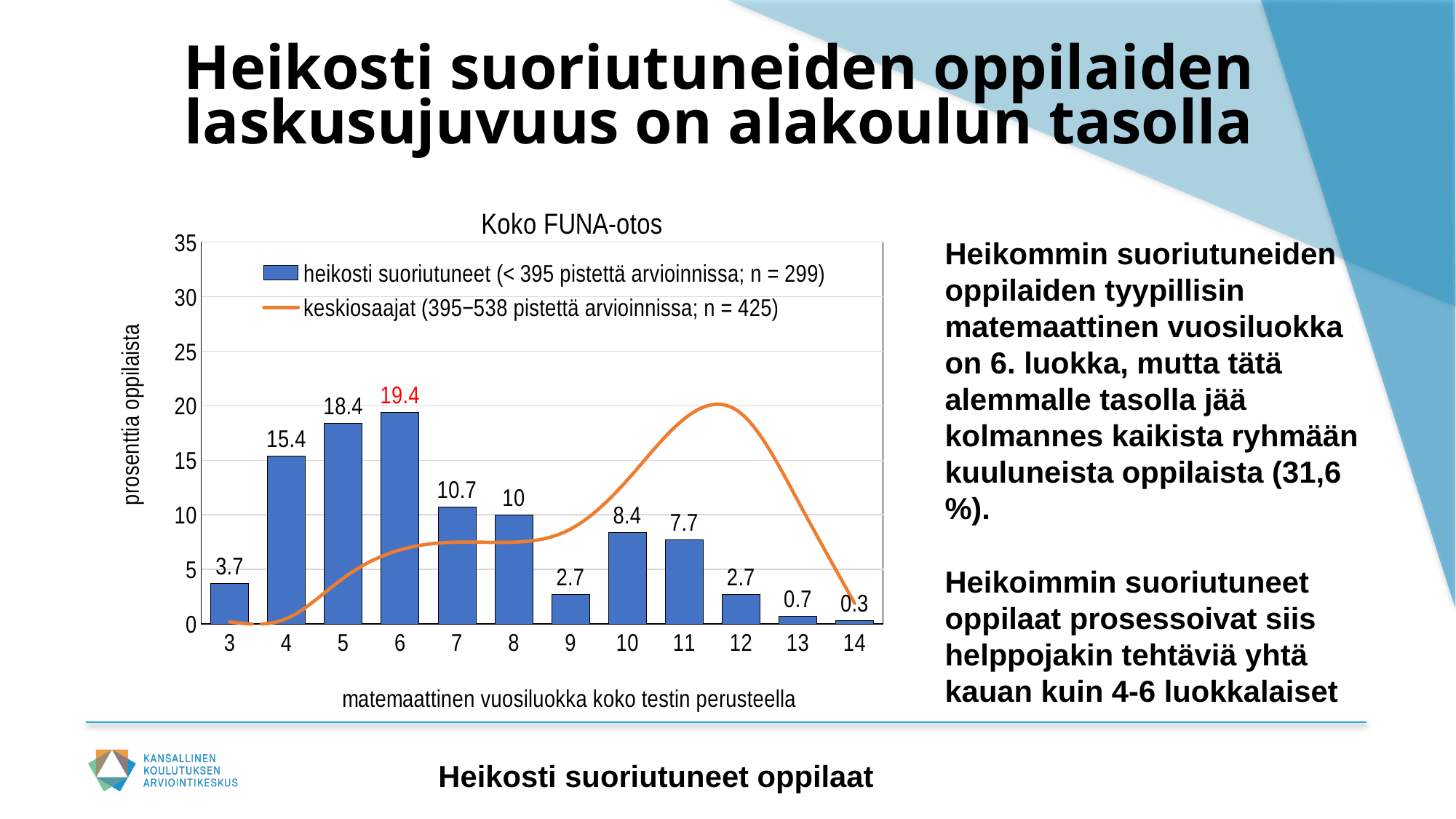
What is the value of the heikosti suoriutuneet bar for grade 6? 19.4 How many series does the legend list? 2 What is the chart's title? Koko FUNA-otos What is the label of the y axis? prosenttia oppilaista Is the keskiosaajat line value at grade 11 greater or less than 15? greater What is the value of the heikosti suoriutuneet bar for grade 14? 0.3 Which is larger for heikosti suoriutuneet: the bar for grade 10 or the bar for grade 11? grade 10 What is the difference between the heikosti suoriutuneet bars for grade 5 and grade 7? 7.7 Which grade has the highest heikosti suoriutuneet bar? 6 What is the value of the heikosti suoriutuneet bar for grade 4? 15.4 Which grade has the lowest heikosti suoriutuneet bar? 14 How many grade categories are shown on the x axis? 12